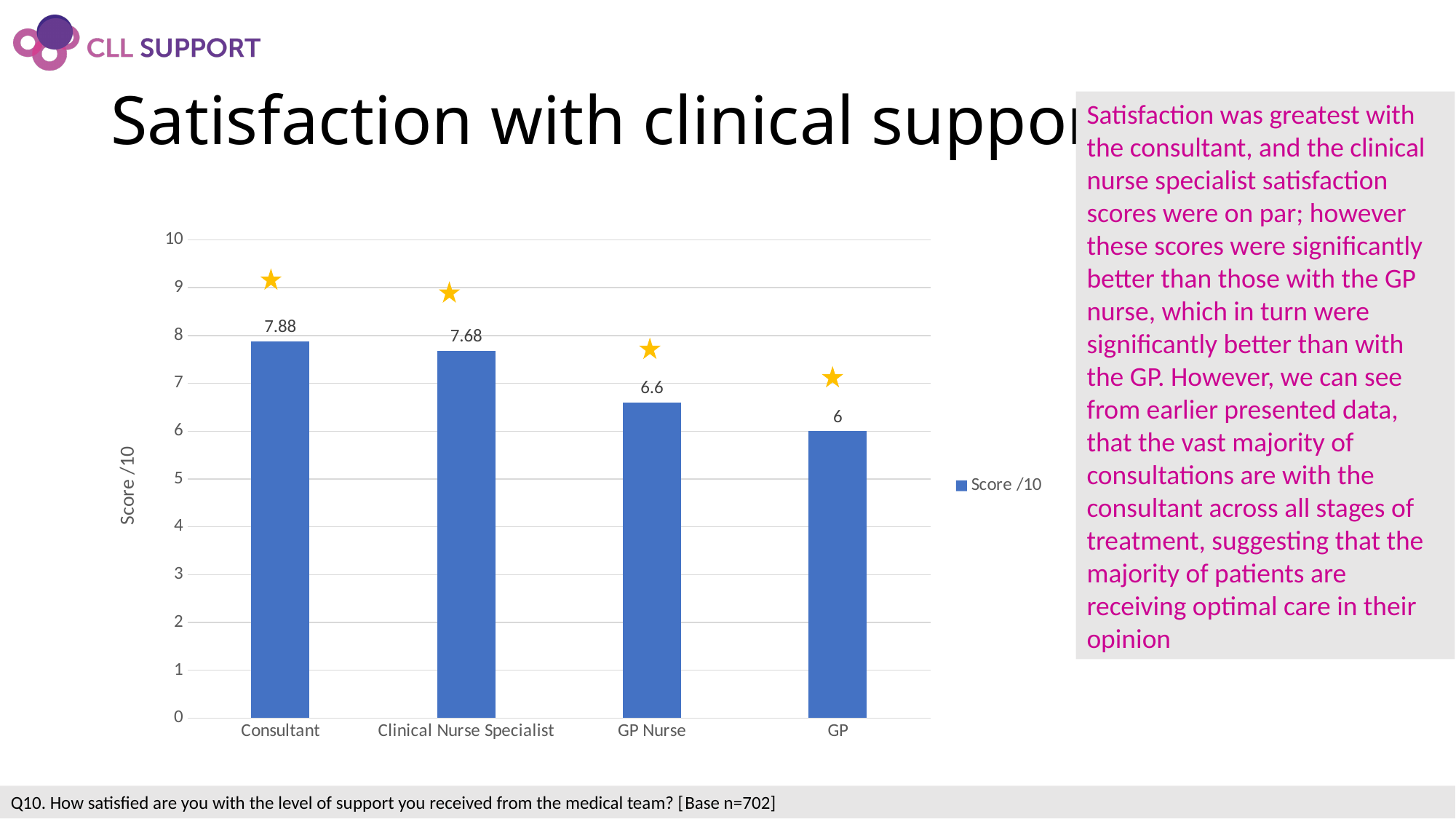
Which category has the lowest score? GP Do the scores rise or fall from left to right along the x axis? Fall What is the score for GP Nurse? 6.6 How many categories are shown on the x axis? 4 Which category has the highest score? Consultant What is the score for Clinical Nurse Specialist? 7.68 Which is larger, the score for GP Nurse or the score for GP? GP Nurse How many series does the legend list? 1 What is the score for Consultant? 7.88 What kind of chart is shown? Bar chart What is the difference between the Consultant score and the GP score? 1.88 What is the score for GP? 6